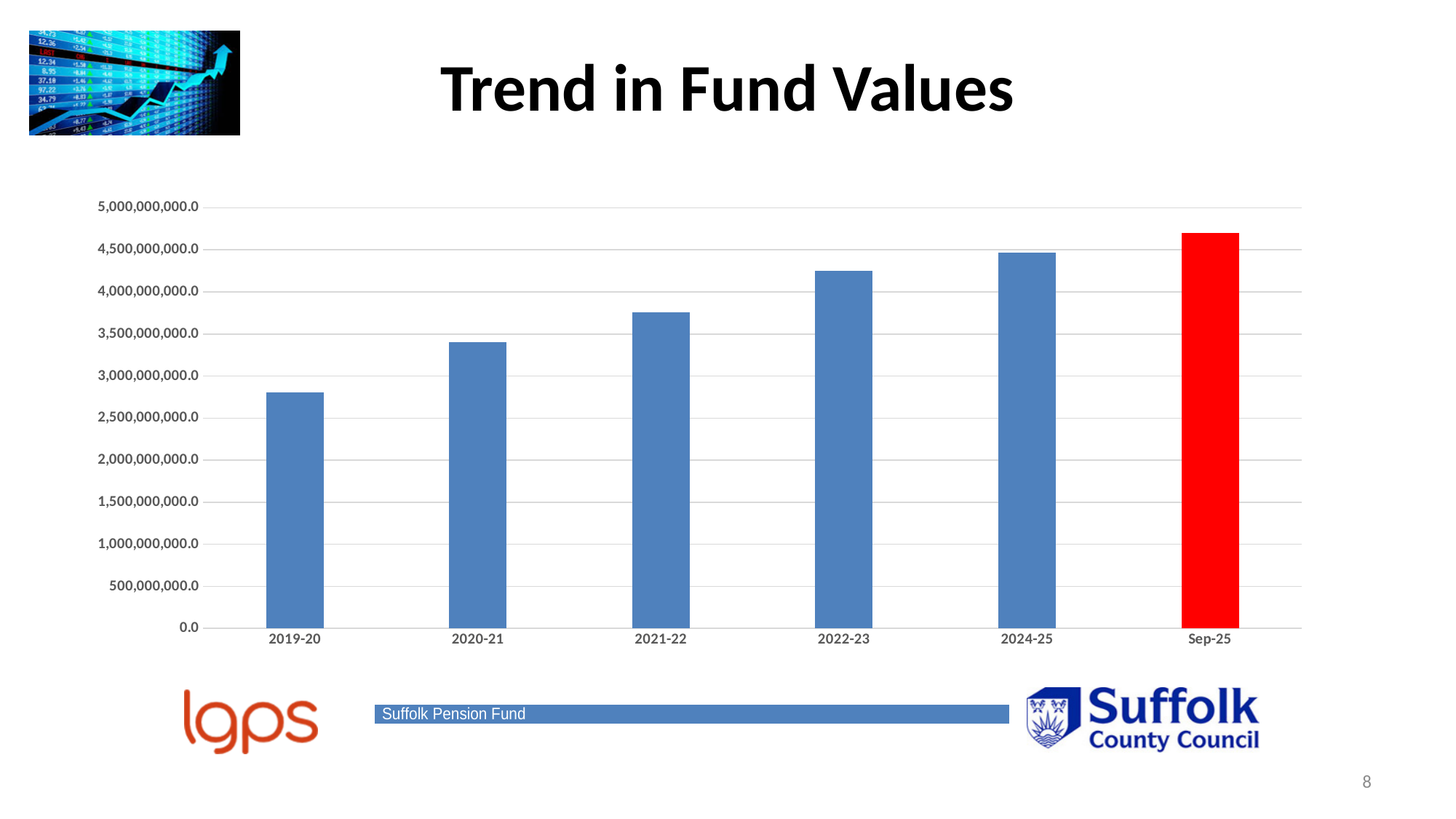
Is the value for 2020-21 greater or less than 3,000,000,000.0? greater Is the value for 2022-23 greater or less than 4,000,000,000.0? greater Do the fund values rise or fall from 2019-20 to Sep-25? rise Is the value for Sep-25 greater or less than 4,500,000,000.0? greater Which category has the lowest fund value? 2019-20 Which category has the highest fund value? Sep-25 How many categories are shown on the x axis of the chart? 6 What is the title of the chart? Trend in Fund Values Which bar is coloured differently from the others, and what colour is it? Sep-25, red What kind of chart is shown on the slide? bar chart